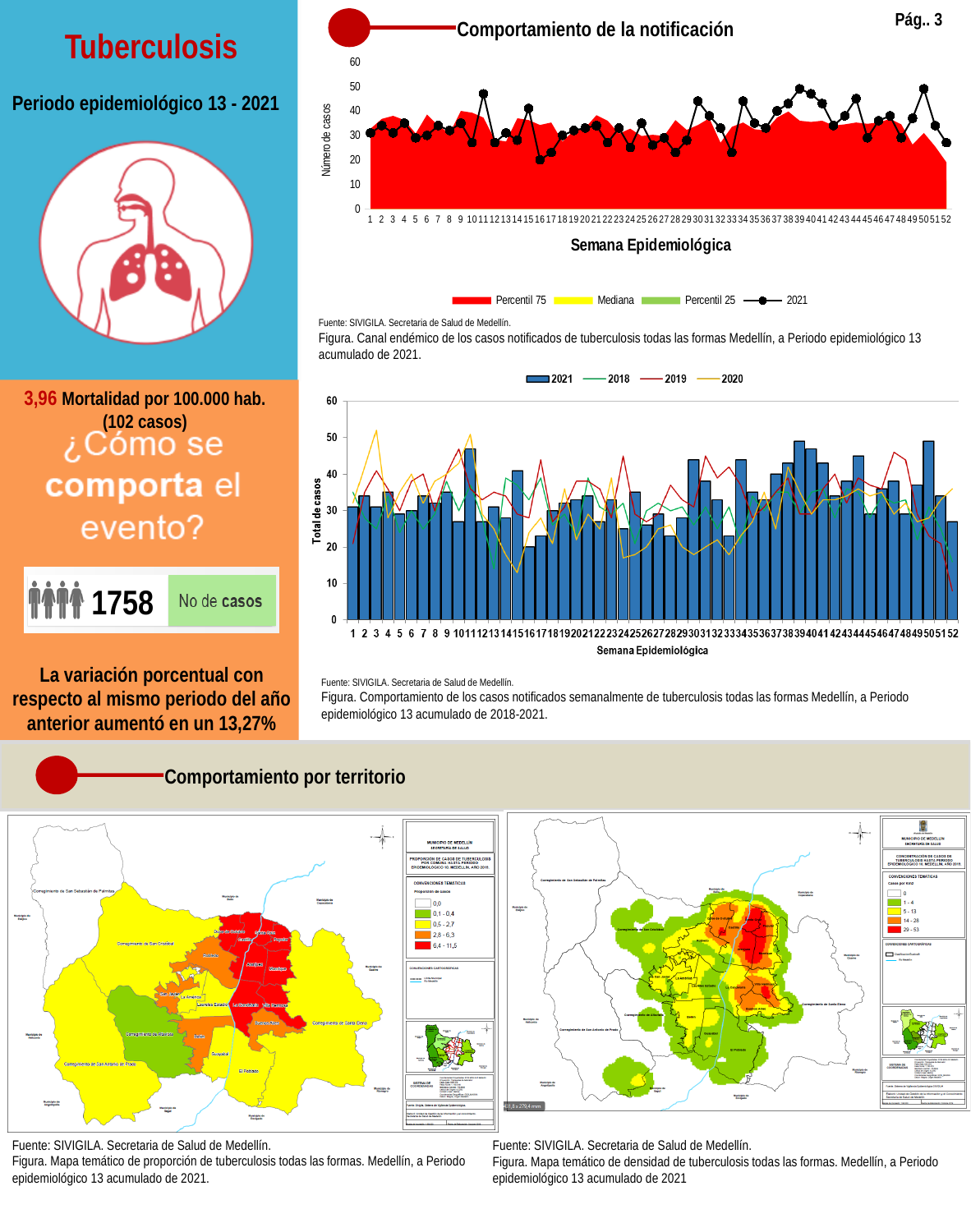
In the bottom chart (weekly cases 2018-2021), is the 2021 bar at week 11 greater or less than 40? greater In the bottom chart (weekly cases 2018-2021), is the 2021 bar at week 17 greater or less than 30? less How many series does the legend of the bottom chart (weekly cases 2018-2021) list? 4 In the bottom chart (weekly cases 2018-2021), what kind of chart is used for the 2021 series? bar chart In the top chart 'Comportamiento de la notificación', which 2021 value is larger: week 39 or week 16? week 39 In the bottom chart (weekly cases 2018-2021), which 2021 bar is taller: week 11 or week 17? week 11 In the top chart 'Comportamiento de la notificación', what is the label of the y axis? Número de casos How many series does the legend of the top chart 'Comportamiento de la notificación' list? 4 In the top chart 'Comportamiento de la notificación', is the 2021 value at week 39 greater or less than 40? greater In the bottom chart (weekly cases 2018-2021), what is the label of the y axis? Total de casos How many epidemiological weeks are shown on the x axis of the bottom chart (weekly cases 2018-2021)? 52